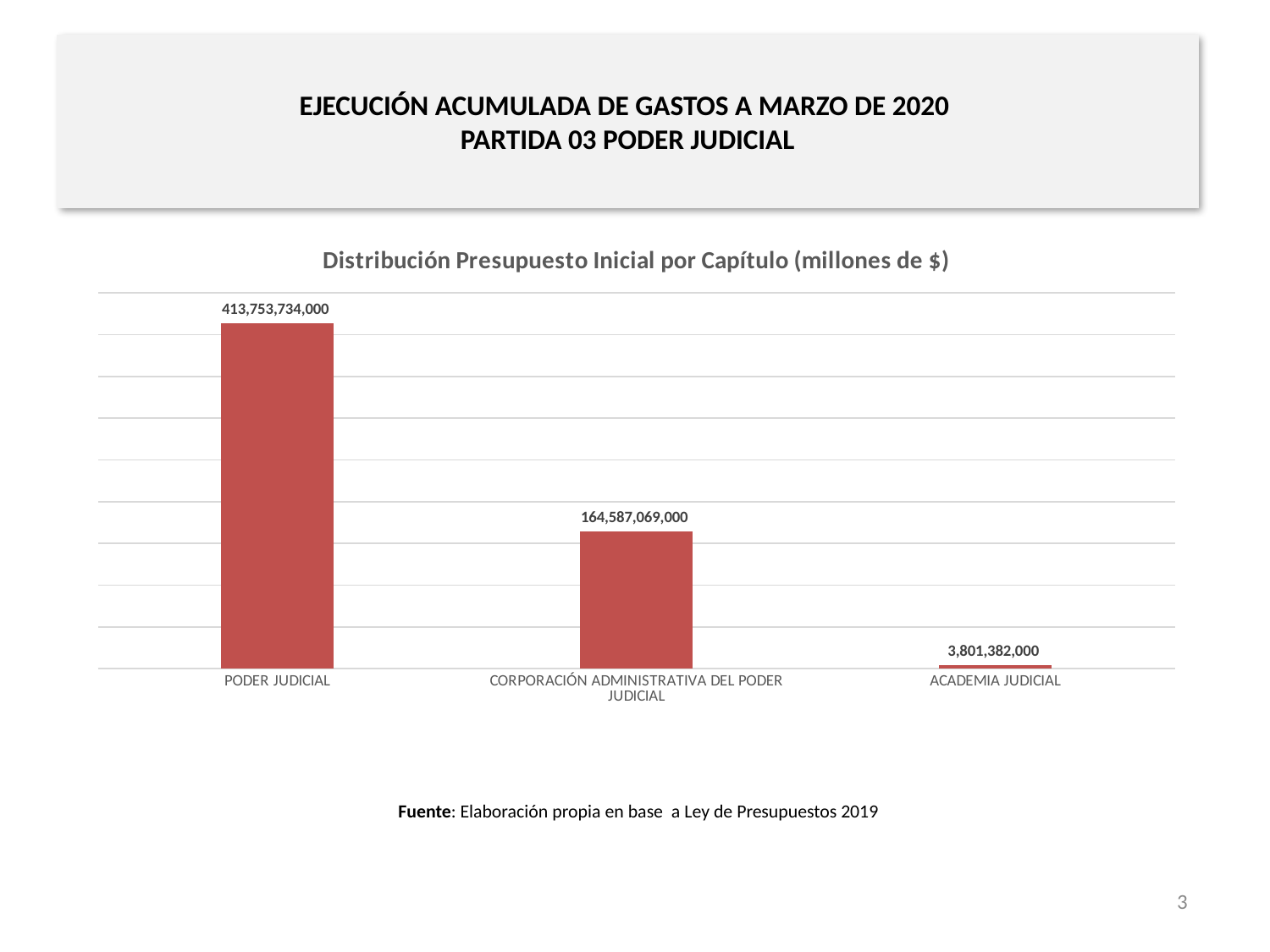
What is the value for CORPORACIÓN ADMINISTRATIVA DEL PODER JUDICIAL? 164,587,069,000 Do the values rise or fall from left to right across the categories? Fall What is the title of the chart? Distribución Presupuesto Inicial por Capítulo (millones de $) What is the value for PODER JUDICIAL? 413,753,734,000 How many categories are shown in the chart? 3 Which is larger, the value for CORPORACIÓN ADMINISTRATIVA DEL PODER JUDICIAL or the value for ACADEMIA JUDICIAL? CORPORACIÓN ADMINISTRATIVA DEL PODER JUDICIAL Which category has the highest value? PODER JUDICIAL What kind of chart is shown on the slide? Bar chart What is the difference between the values for PODER JUDICIAL and CORPORACIÓN ADMINISTRATIVA DEL PODER JUDICIAL? 249,166,665,000 What is the difference between the values for CORPORACIÓN ADMINISTRATIVA DEL PODER JUDICIAL and ACADEMIA JUDICIAL? 160,785,687,000 Which category has the lowest value? ACADEMIA JUDICIAL What is the value for ACADEMIA JUDICIAL? 3,801,382,000